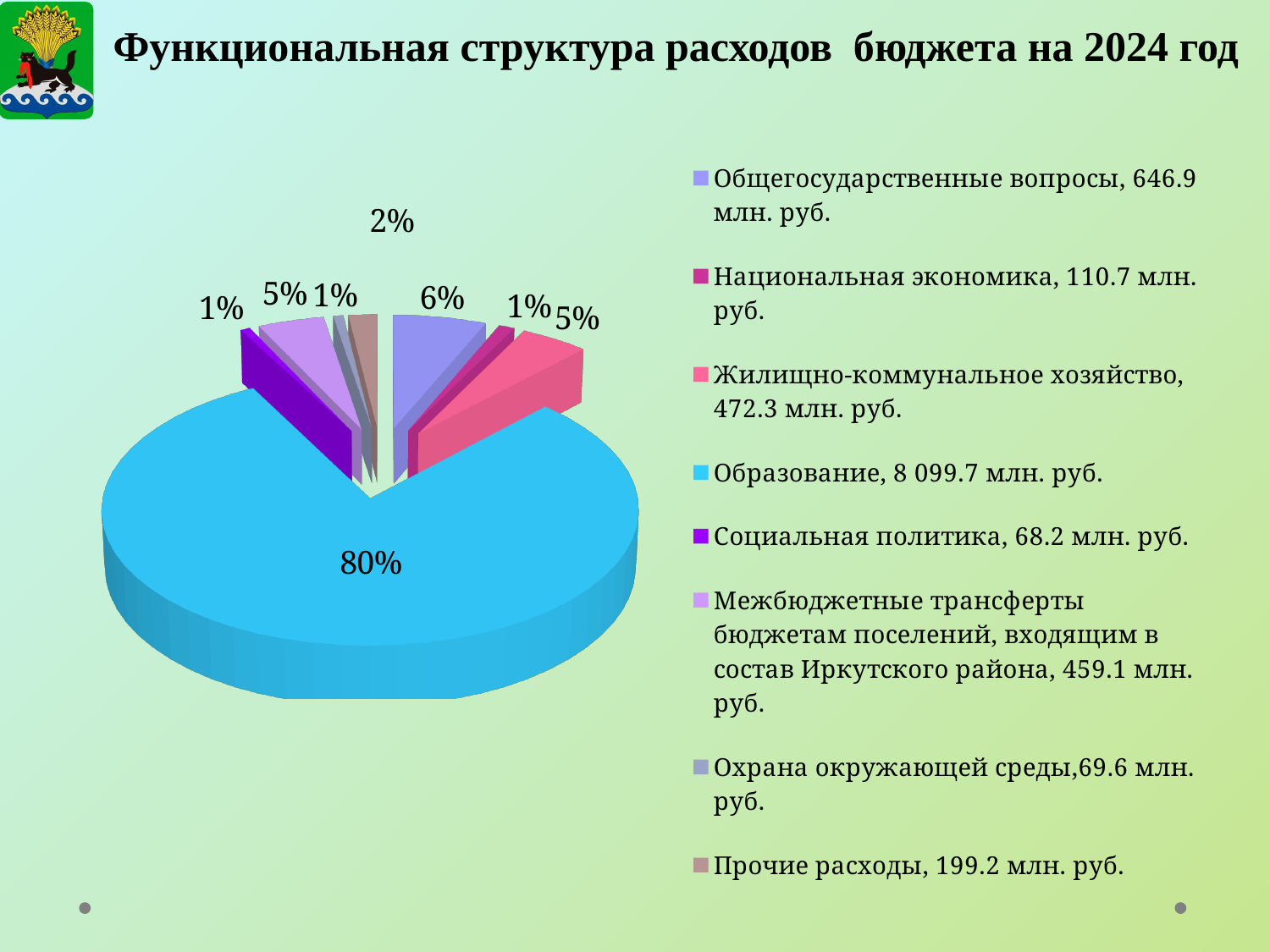
What value is given in the legend for Образование? 8 099.7 млн. руб. Which is larger, the value for Общегосударственные вопросы or the value for Жилищно-коммунальное хозяйство? Общегосударственные вопросы What value is given in the legend for Жилищно-коммунальное хозяйство? 472.3 млн. руб. Which category has the smallest value according to the legend? Социальная политика How many categories does the legend of the pie chart list? 8 What kind of chart is shown on the slide? pie chart What is the difference between the values for Общегосударственные вопросы and Национальная экономика in the legend? 536.2 млн. руб. What share of the pie does Общегосударственные вопросы take? 6% What value is given in the legend for Прочие расходы? 199.2 млн. руб. Which category has the largest share of the pie? Образование What share of the pie does Образование take? 80% What is the title of the slide containing the pie chart? Функциональная структура расходов бюджета на 2024 год